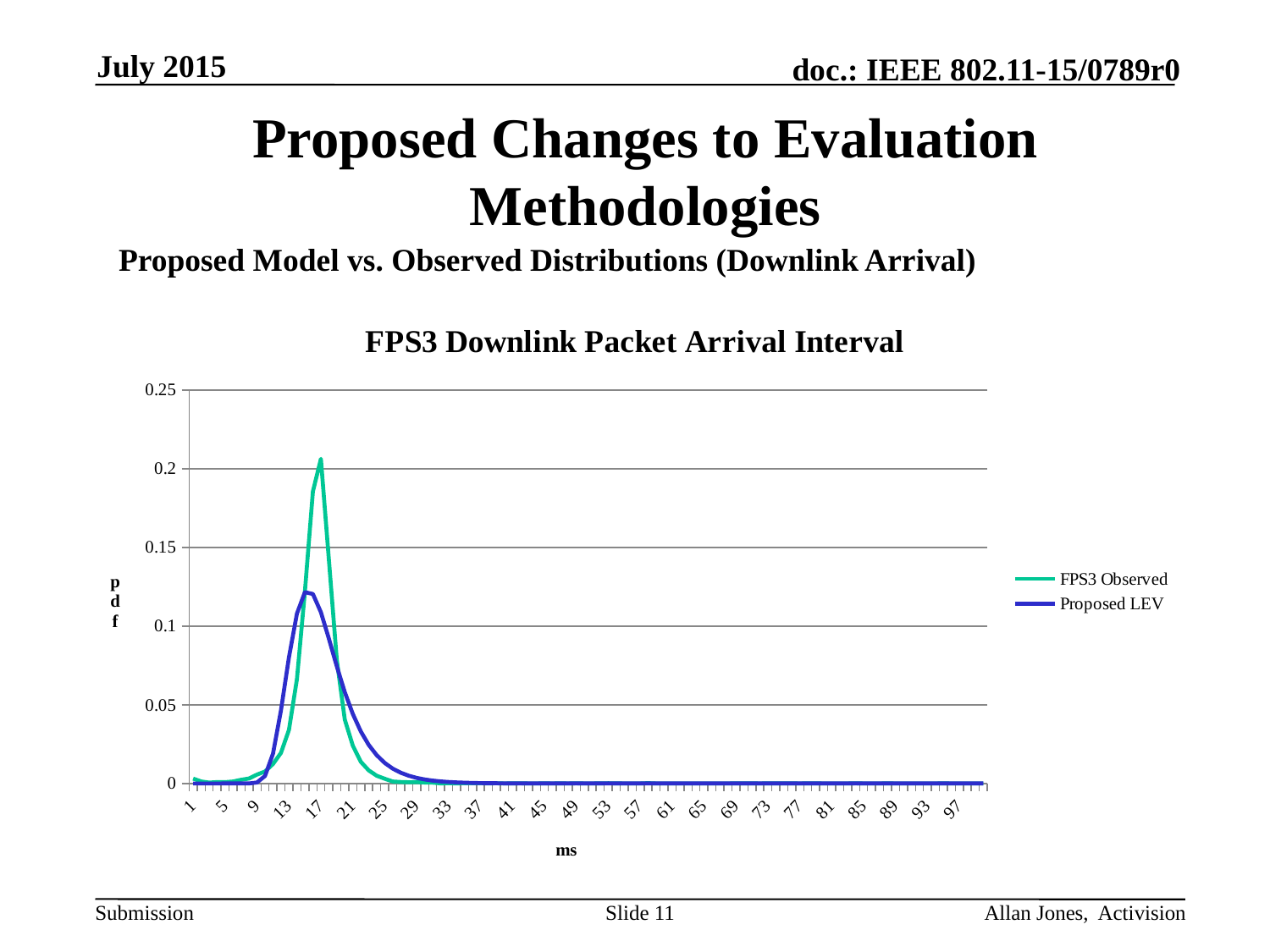
Which series has the wider spread around its peak, FPS3 Observed or Proposed LEV? Proposed LEV What kind of chart is shown on the slide? line chart Is the value of the FPS3 Observed series at 1 ms greater or less than 0.05? less Is the value of the Proposed LEV series at 41 ms greater or less than 0.05? less What is the label of the x axis? ms Which series reaches the higher peak value, FPS3 Observed or Proposed LEV? FPS3 Observed What is the title of the chart? FPS3 Downlink Packet Arrival Interval How many series does the legend list? 2 Is the peak value of the FPS3 Observed series greater or less than 0.15? greater After the peak near 17 ms, do the values of both series rise or fall as ms increases? fall